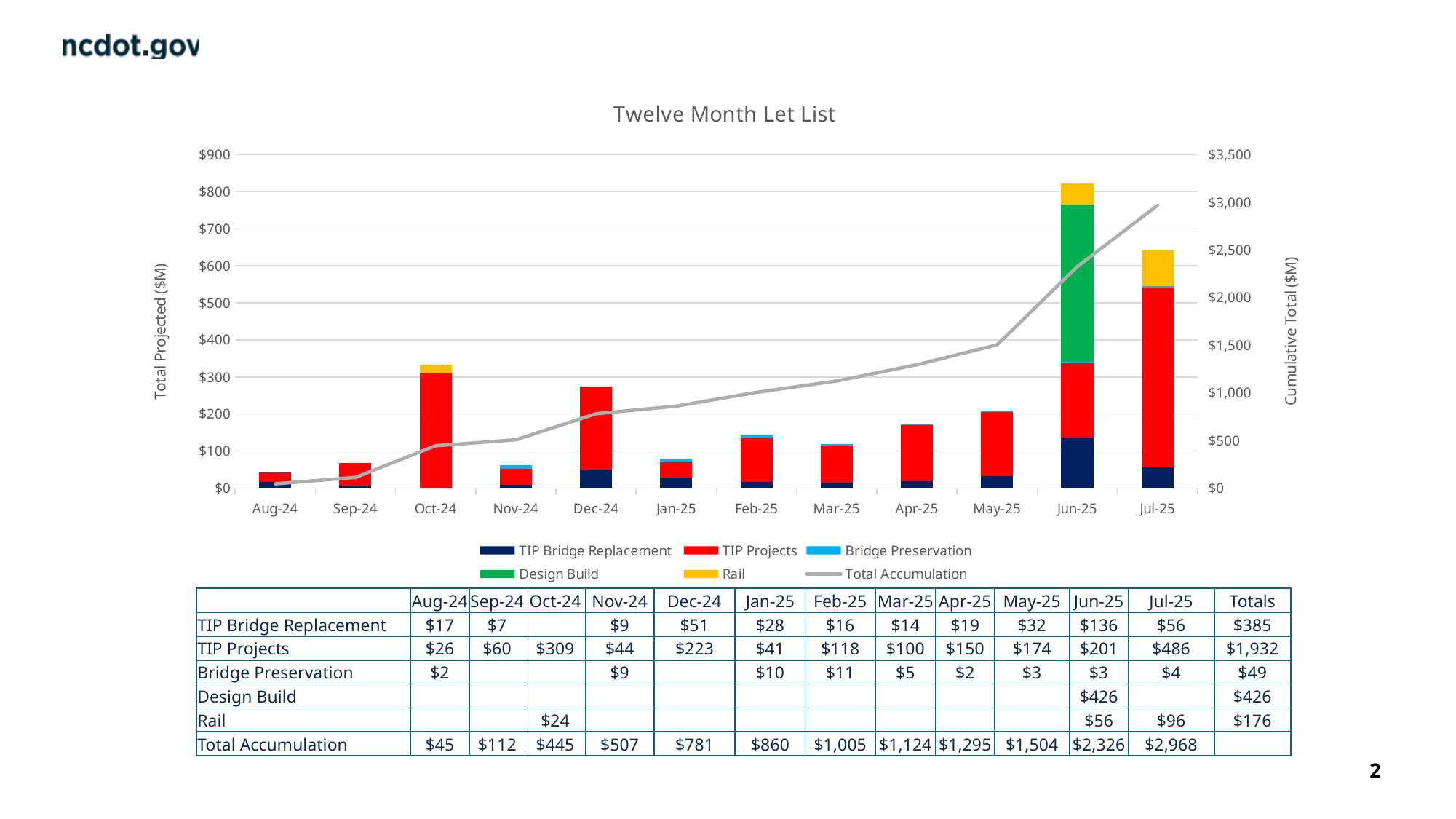
What is the TIP Projects value for Oct-24? $309 Which is larger, the Rail value for Jul-25 or for Oct-24? Jul-25 What is the total of the stacked bar for Jun-25? $822 How many series does the legend list? 6 What is the Design Build value for Jun-25? $426 What is the Total Accumulation value for Jul-25? $2,968 What kind of chart is shown on the slide? bar chart with a line Does the Total Accumulation line rise or fall from Aug-24 to Jul-25? rise What is the difference between the TIP Bridge Replacement values for Jun-25 and Jul-25? $80 Which month has the tallest stacked bar? Jun-25 How many months are shown along the x axis? 12 Which month has the highest TIP Projects value? Jul-25